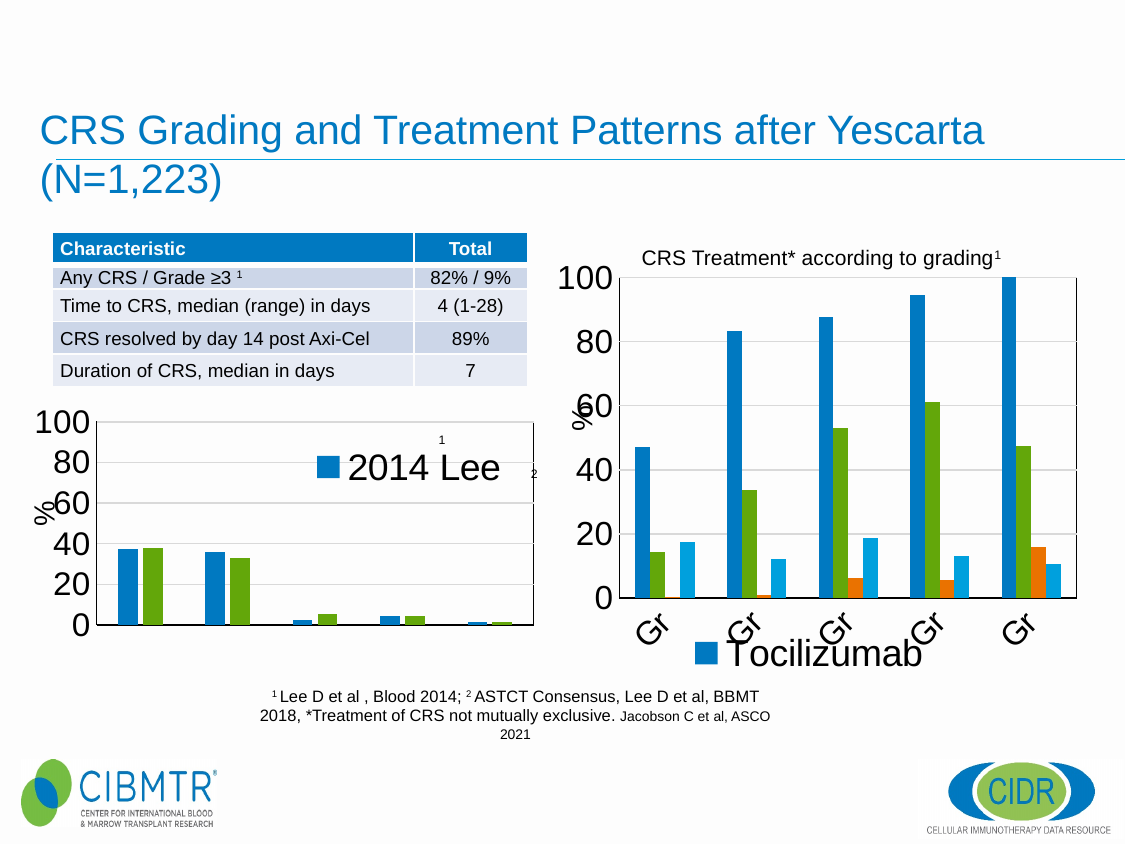
What kind of chart is the chart titled "CRS Treatment* according to grading"? bar chart In the chart titled "CRS Treatment* according to grading", is the Tocilizumab value for the second group from the left greater or less than 80? greater In the chart titled "CRS Treatment* according to grading", which group has the lowest Tocilizumab value? the leftmost (first) group In the bottom-left chart with the "2014 Lee" legend, how many groups of bars are plotted? 5 In the chart titled "CRS Treatment* according to grading", do the Tocilizumab values rise or fall from left to right across the groups? rise In the chart titled "CRS Treatment* according to grading", which group has the highest Tocilizumab value? the rightmost (fifth) group What is the title of the chart on the right side of the slide? CRS Treatment* according to grading In the chart titled "CRS Treatment* according to grading", is the Tocilizumab value for the leftmost group greater or less than 60? less In the chart titled "CRS Treatment* according to grading", is the Tocilizumab value for the leftmost group greater or less than 40? greater What kind of chart is the bottom-left chart with the "2014 Lee" legend? bar chart In the chart titled "CRS Treatment* according to grading", how many groups of bars are plotted along the x axis? 5